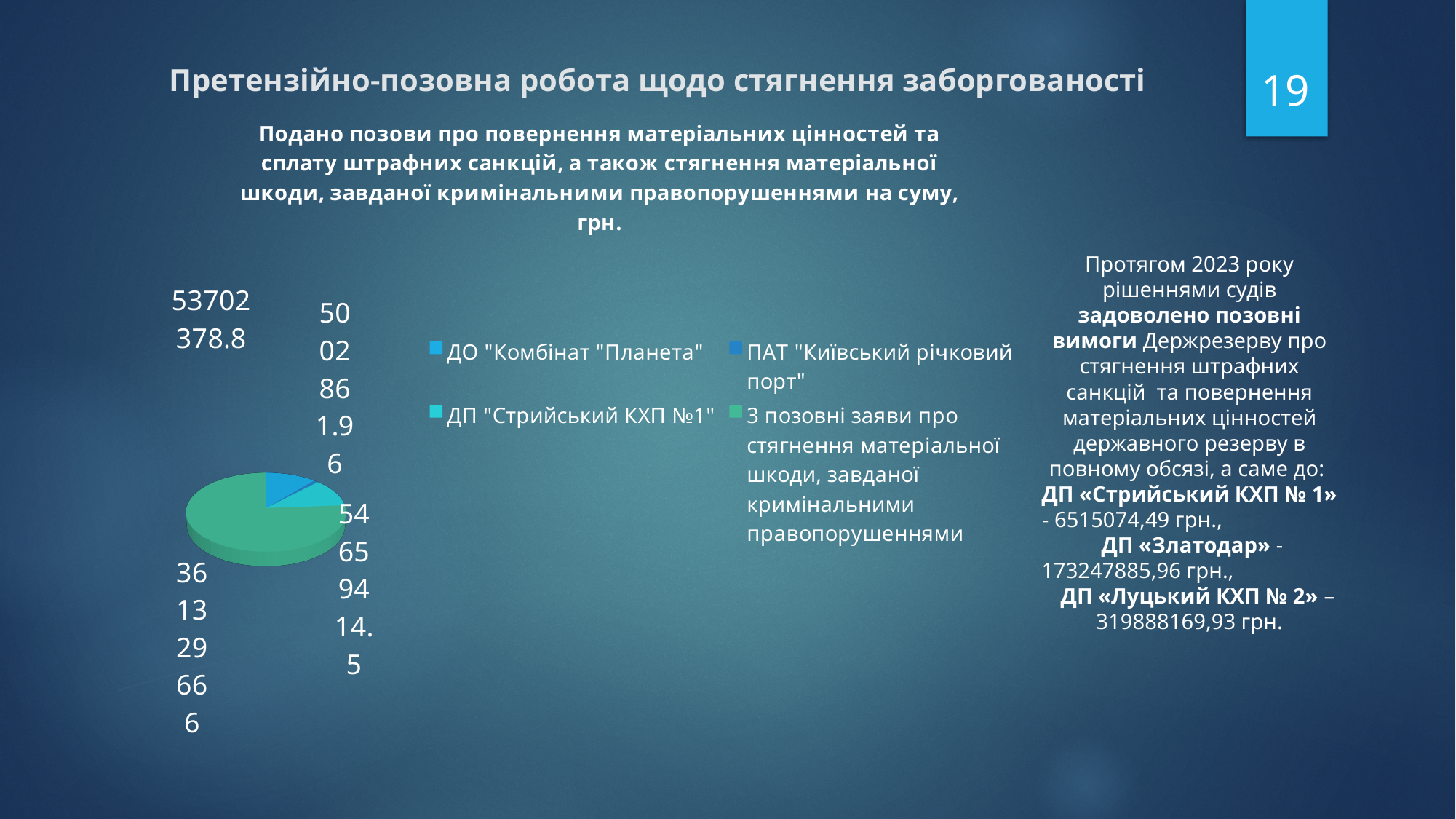
How many entries does the legend of the pie chart list? 4 Is the slice for "3 позовні заяви про стягнення матеріальної шкоди, завданої кримінальними правопорушеннями" larger or smaller than the slice for ПАТ "Київський річковий порт"? Larger Which category has the largest slice in the pie chart? 3 позовні заяви про стягнення матеріальної шкоди, завданої кримінальними правопорушеннями Does the largest slice of the pie chart account for more or less than half of the pie? More What is the title of the pie chart? Подано позови про повернення матеріальних цінностей та сплату штрафних санкцій, а також стягнення матеріальної шкоди, завданої кримінальними правопорушеннями на суму, грн. What kind of chart is shown on the slide? Pie chart What colour is the largest slice of the pie chart? Green